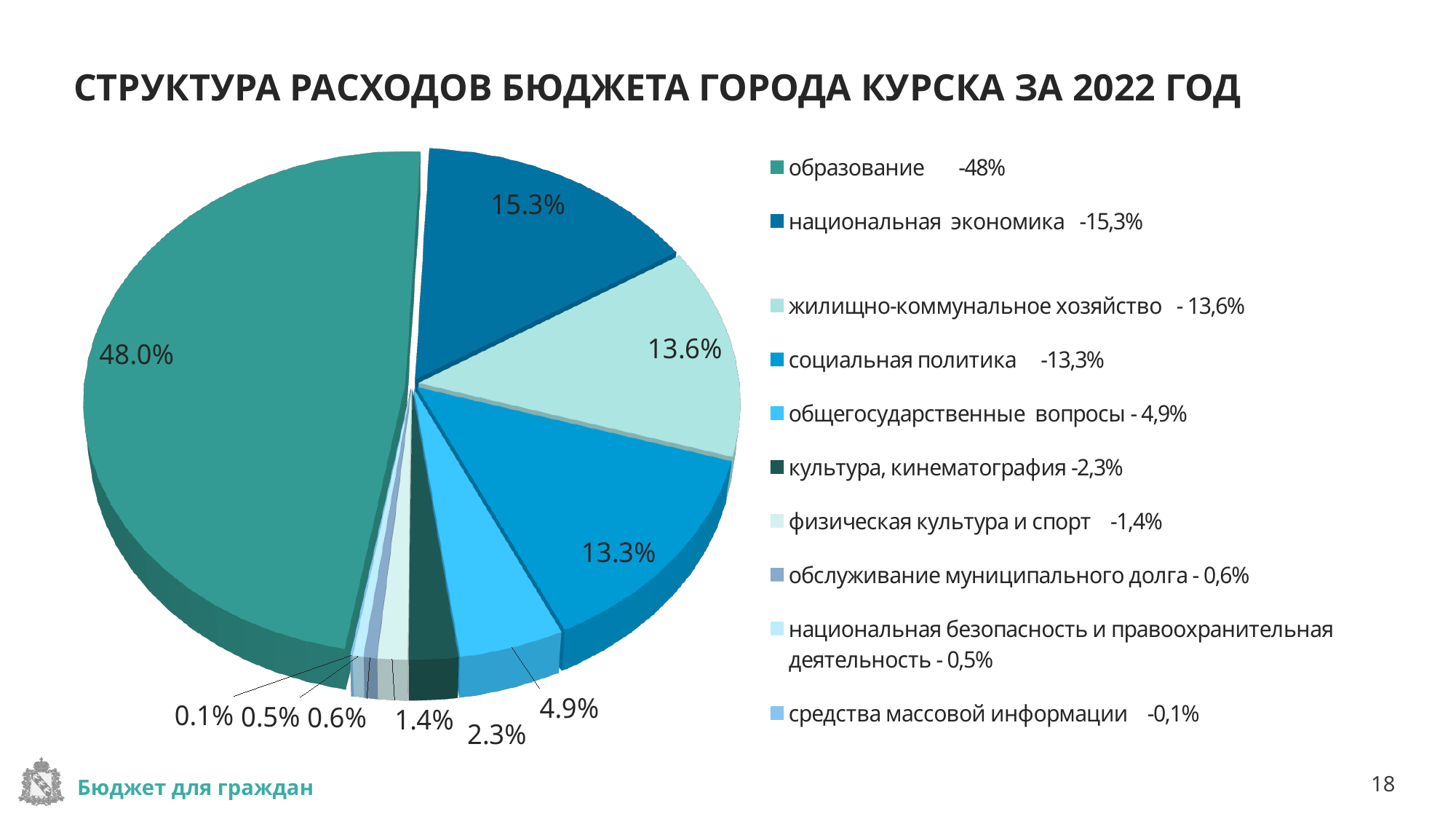
What is the value shown for культура, кинематография? 2.3% What kind of chart is shown on the slide? Pie chart Which category has the smallest slice of the pie? средства массовой информации What is the value shown for жилищно-коммунальное хозяйство? 13.6% What is the title of the chart on the slide? СТРУКТУРА РАСХОДОВ БЮДЖЕТА ГОРОДА КУРСКА ЗА 2022 ГОД What is the difference between the shares for национальная экономика and социальная политика? 2.0% What is the value shown for социальная политика? 13.3% What share of the budget expenditure goes to образование? 48.0% How many categories does the legend list? 10 Which category has the largest slice of the pie? образование What is the value shown for национальная экономика? 15.3% Which is larger, the share for общегосударственные вопросы or the share for физическая культура и спорт? общегосударственные вопросы